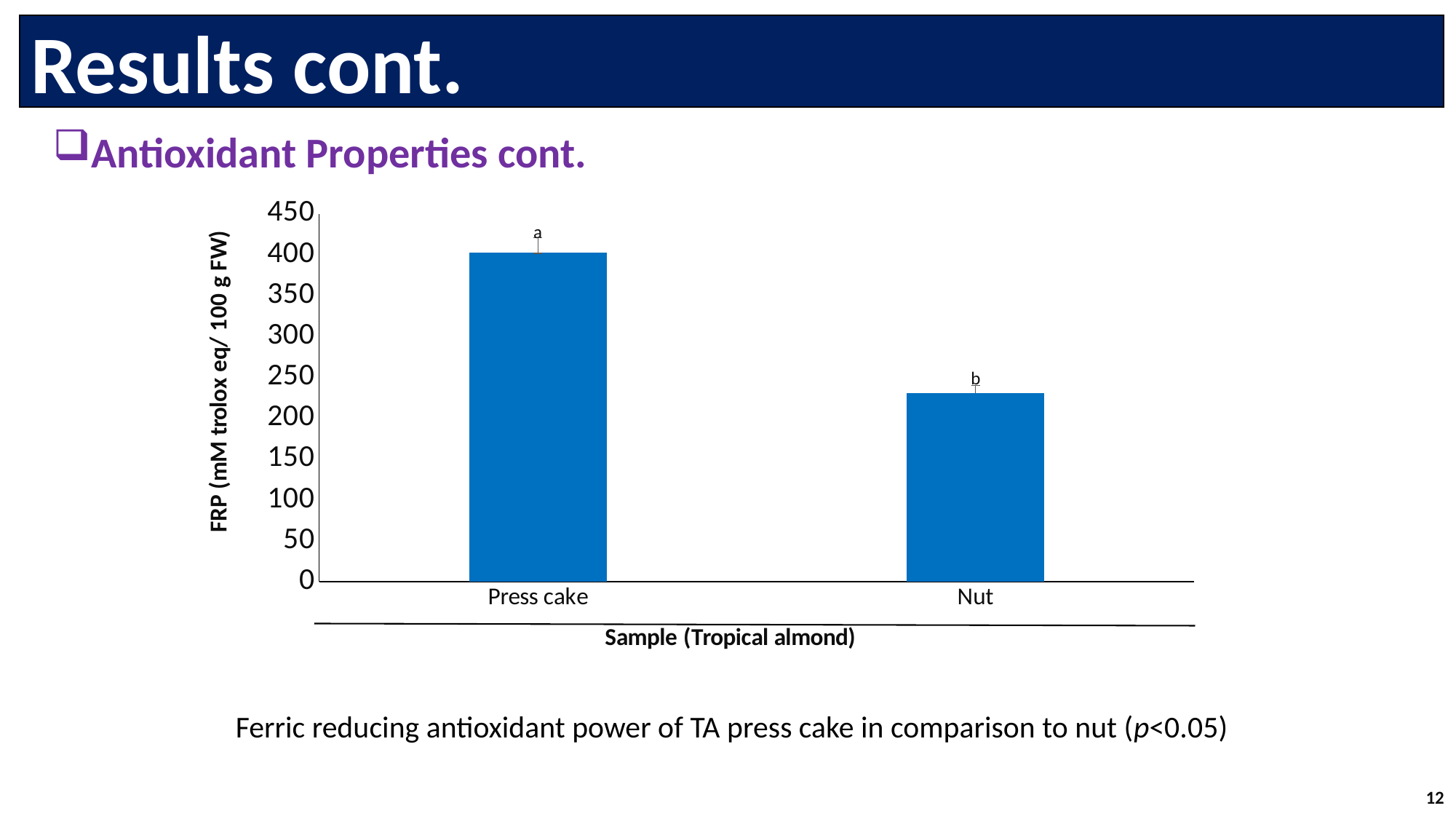
Which sample has the lowest FRP value in the chart? Nut Is the FRP value for Nut greater or less than 250? less What is the label of the y axis of the chart? FRP (mM trolox eq/ 100 g FW) Is the FRP value for Press cake greater or less than 450? less Is the FRP value for Press cake greater or less than 350? greater What is the label of the x axis of the chart? Sample (Tropical almond) Do the values fall or rise from Press cake to Nut along the x axis? fall Which has a larger FRP value, Press cake or Nut? Press cake Which sample has the highest FRP value in the chart? Press cake How many categories are plotted on the x axis of the chart? 2 What kind of chart is shown on the slide? bar chart